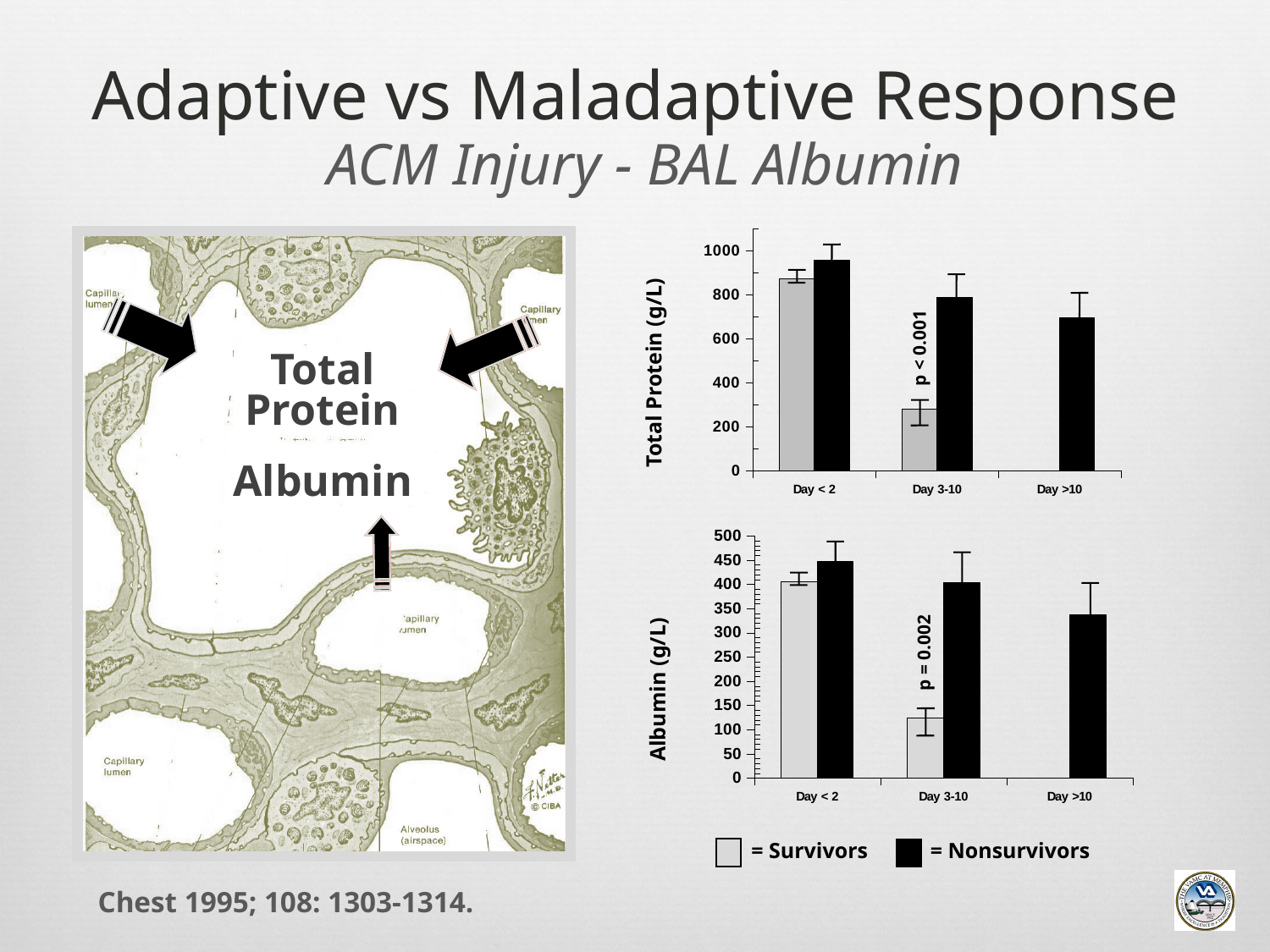
In the Total Protein (g/L) chart, which bar is the lowest? Survivors, Day 3-10 How many day categories are shown on the x axis of the Albumin (g/L) chart? 3 In the Albumin (g/L) chart, which bar is the highest? Nonsurvivors, Day < 2 How many series does the legend below the charts list? 2 What kind of chart is the Total Protein (g/L) chart? bar chart In the Total Protein (g/L) chart, do the Nonsurvivors values rise or fall from Day < 2 to Day >10? fall In the Albumin (g/L) chart, is the Survivors value for Day 3-10 greater or less than 200? less In the Albumin (g/L) chart, is the Nonsurvivors value for Day >10 greater or less than 300? greater What p-value is printed on the Albumin (g/L) chart at Day 3-10? p = 0.002 In the Total Protein (g/L) chart, is the Nonsurvivors value for Day 3-10 greater or less than 600? greater In the Total Protein (g/L) chart, which is larger at Day 3-10, Survivors or Nonsurvivors? Nonsurvivors